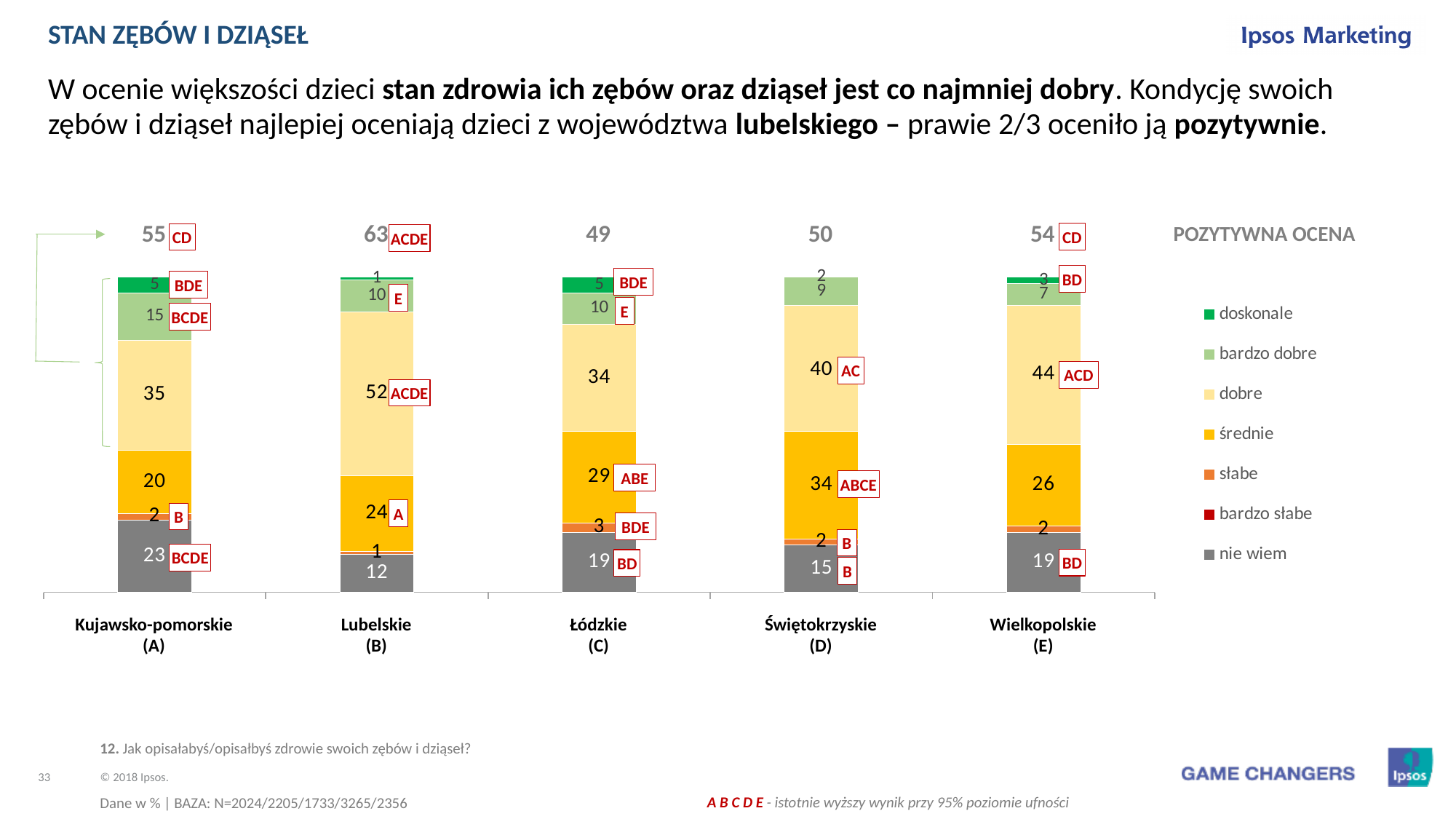
How many voivodeships (categories) are shown on the x axis? 5 What is the 'POZYTYWNA OCENA' value shown above the bar for Wielkopolskie (E)? 54 Which is larger: the 'średnie' value for Łódzkie (C) or for Wielkopolskie (E)? Łódzkie (C) What is the difference between the 'dobre' values for Lubelskie (B) and Łódzkie (C)? 18 What is the 'dobre' value for Lubelskie (B)? 52 What is the 'nie wiem' value for Kujawsko-pomorskie (A)? 23 Which legend entry is shown in dark green? doskonale Which voivodeship has the lowest 'POZYTYWNA OCENA' value? Łódzkie (C) What type of chart is shown on the slide? stacked bar chart Which voivodeship has the highest 'POZYTYWNA OCENA' value? Lubelskie (B) What is the 'średnie' value for Świętokrzyskie (D)? 34 How many series does the legend list? 7